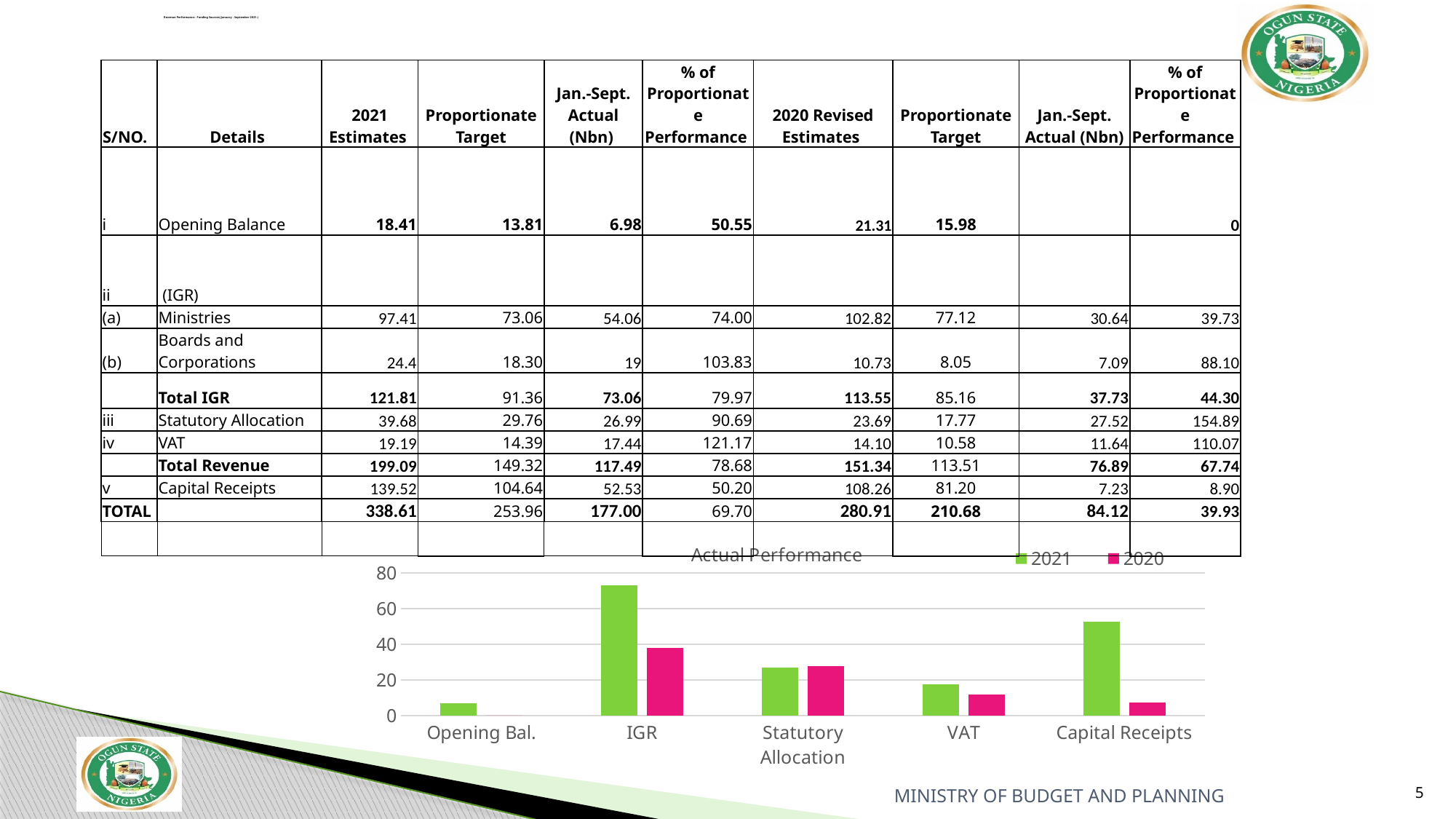
Which category has the highest 2021 bar in the chart? IGR How many categories are shown on the x axis of the chart? 5 Is the 2020 value for VAT greater or less than 20? less Is the 2021 value for Capital Receipts greater or less than 40? greater Which category has the highest 2020 bar in the chart? IGR Which category has the lowest 2021 bar in the chart? Opening Bal. For Capital Receipts, which series has the larger bar, 2021 or 2020? 2021 What is the title of the chart? Actual Performance Which colour represents the 2020 series in the chart? pink How many series does the chart legend list? 2 What kind of chart is shown on the slide? bar chart Is the 2021 value for IGR greater or less than 60? greater